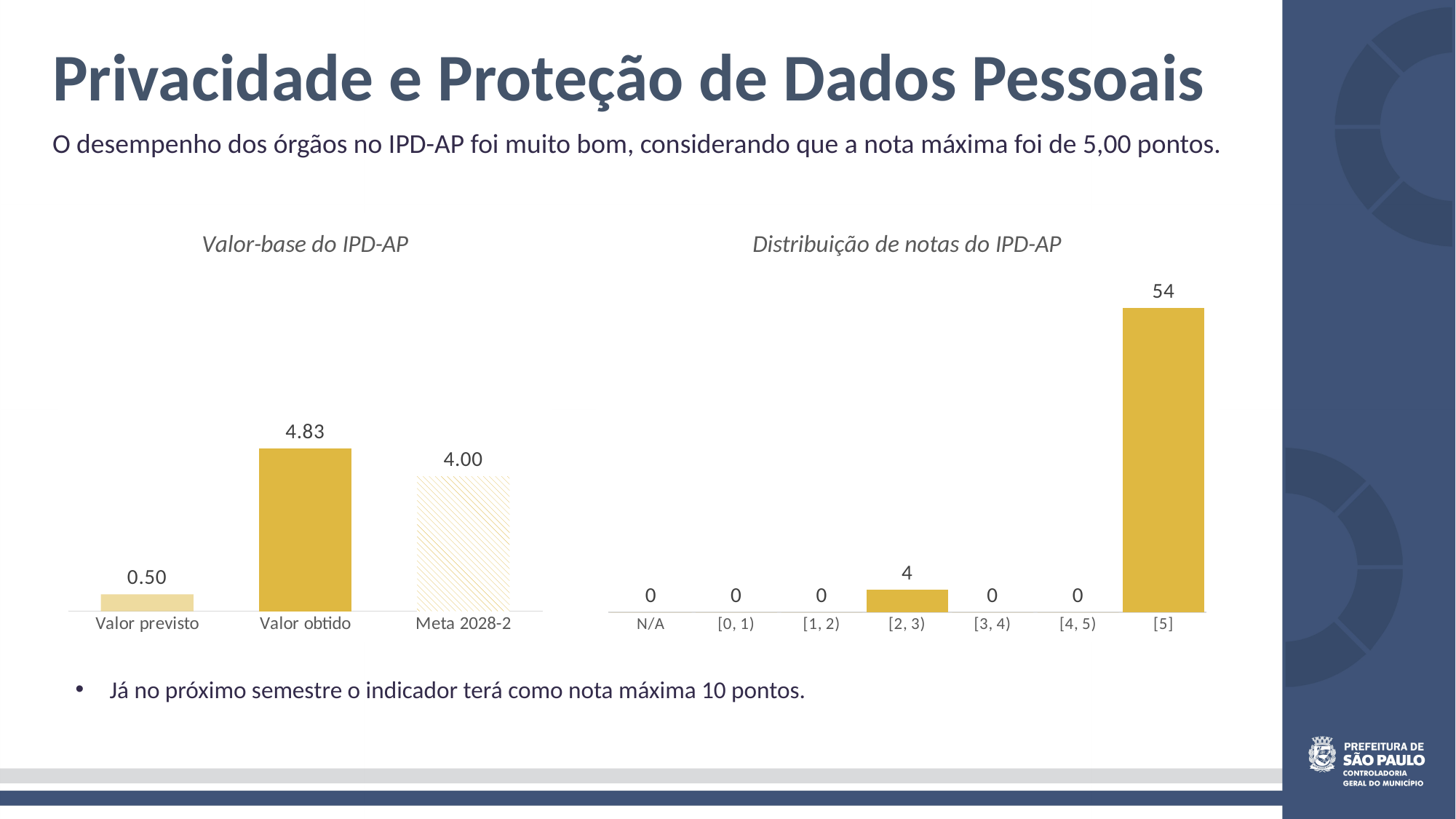
In the 'Distribuição de notas do IPD-AP' chart, what is the value for '[5]'? 54 What type of chart is 'Distribuição de notas do IPD-AP'? Bar chart In the 'Valor-base do IPD-AP' chart, which category has the lowest value? Valor previsto In the 'Distribuição de notas do IPD-AP' chart, what is the value for '[2, 3)'? 4 In the 'Valor-base do IPD-AP' chart, how many categories are shown? 3 In the 'Valor-base do IPD-AP' chart, what is the value for 'Valor previsto'? 0.50 In the 'Valor-base do IPD-AP' chart, what is the value for 'Valor obtido'? 4.83 In the 'Valor-base do IPD-AP' chart, what is the value for 'Meta 2028-2'? 4.00 In the 'Distribuição de notas do IPD-AP' chart, what is the difference between '[5]' and '[2, 3)'? 50 In the 'Distribuição de notas do IPD-AP' chart, how many categories are shown on the x axis? 7 In the 'Valor-base do IPD-AP' chart, which category has the highest value? Valor obtido In the 'Valor-base do IPD-AP' chart, what is the difference between 'Valor obtido' and 'Meta 2028-2'? 0.83